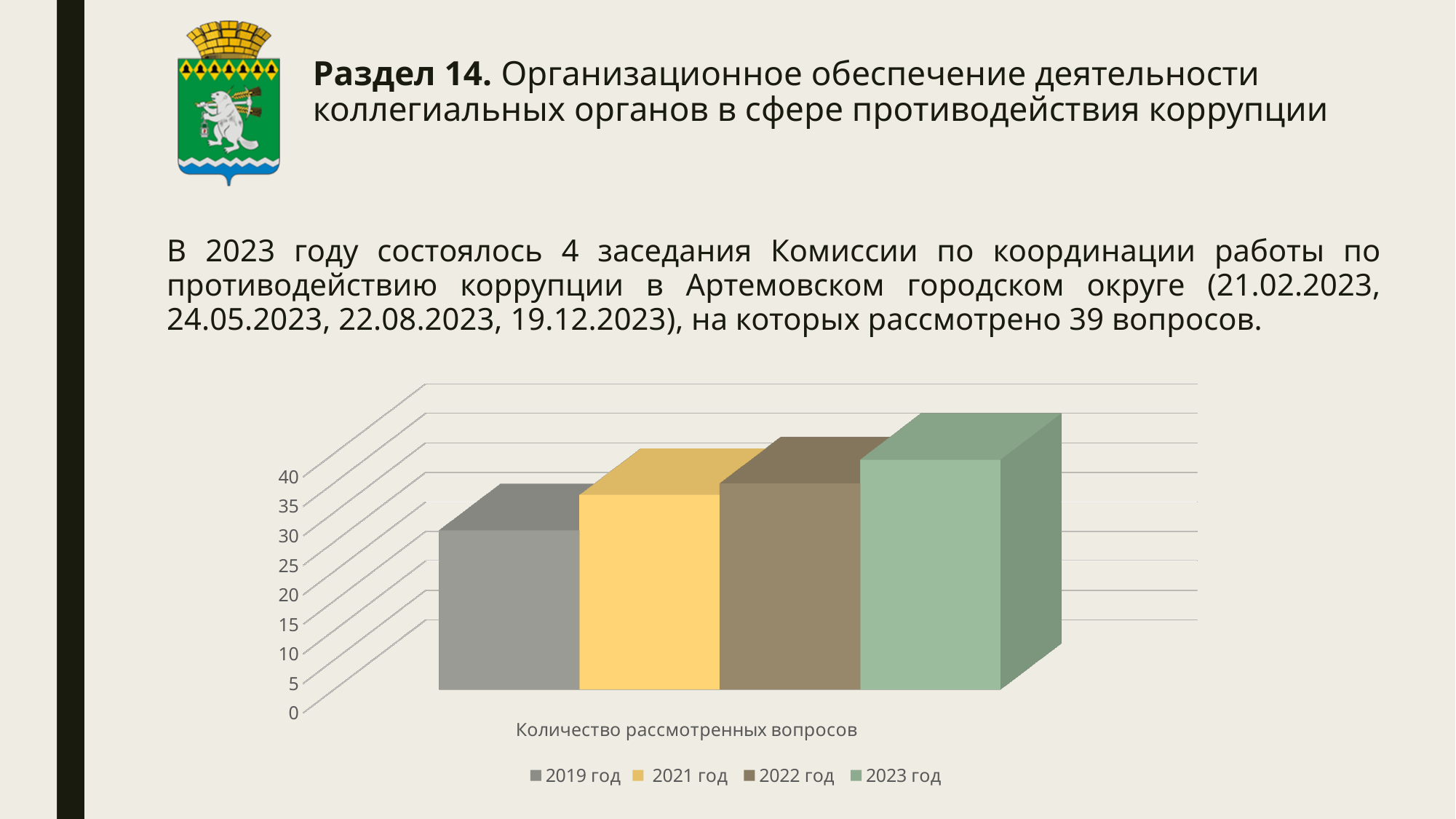
What is the category label shown under the bars of the chart? Количество рассмотренных вопросов Is the value for 2021 год greater or less than 25? greater Is the value for 2023 год greater or less than 30? greater Do the bars rise or fall going from 2019 год to 2023 год? rise How many series does the chart legend list? 4 Which year has the lowest bar in the chart? 2019 год How many categories are shown on the x axis of the chart? 1 Is the value for 2019 год greater or less than 20? greater Which is larger in the chart, the value for 2019 год or the value for 2021 год? 2021 год What kind of chart is shown on the slide? bar chart Which year has the highest bar in the chart? 2023 год Which is larger in the chart, the value for 2019 год or the value for 2023 год? 2023 год